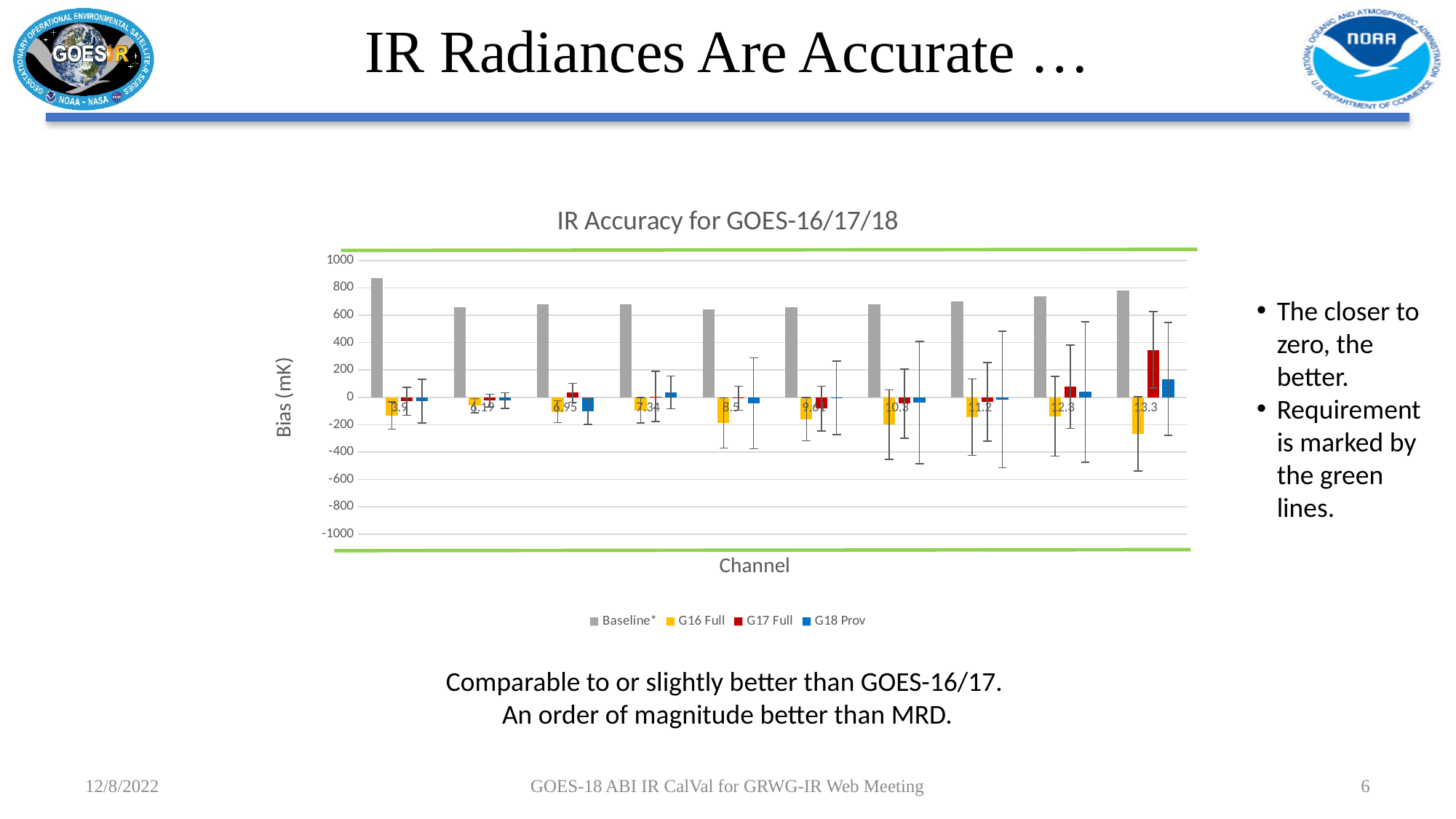
Is the Baseline* value for channel 3.9 greater or less than 800? greater For channel 13.3, which is larger, the G17 Full bar or the G18 Prov bar? G17 Full Is the Baseline* value for channel 8.5 greater or less than 800? less Which is larger, the Baseline* value for channel 3.9 or for channel 13.3? channel 3.9 Is the G17 Full value for channel 13.3 greater or less than 200? greater For which channel is the G17 Full bar the highest? 13.3 For which channel is the Baseline* bar the highest? 3.9 For which channel is the G16 Full bar the lowest (most negative)? 13.3 How many series does the legend of the IR Accuracy chart list? 4 What is the title of the vertical axis of the chart? Bias (mK) How many channel categories are plotted along the x axis of the IR Accuracy chart? 10 What kind of chart is shown on the slide? bar chart